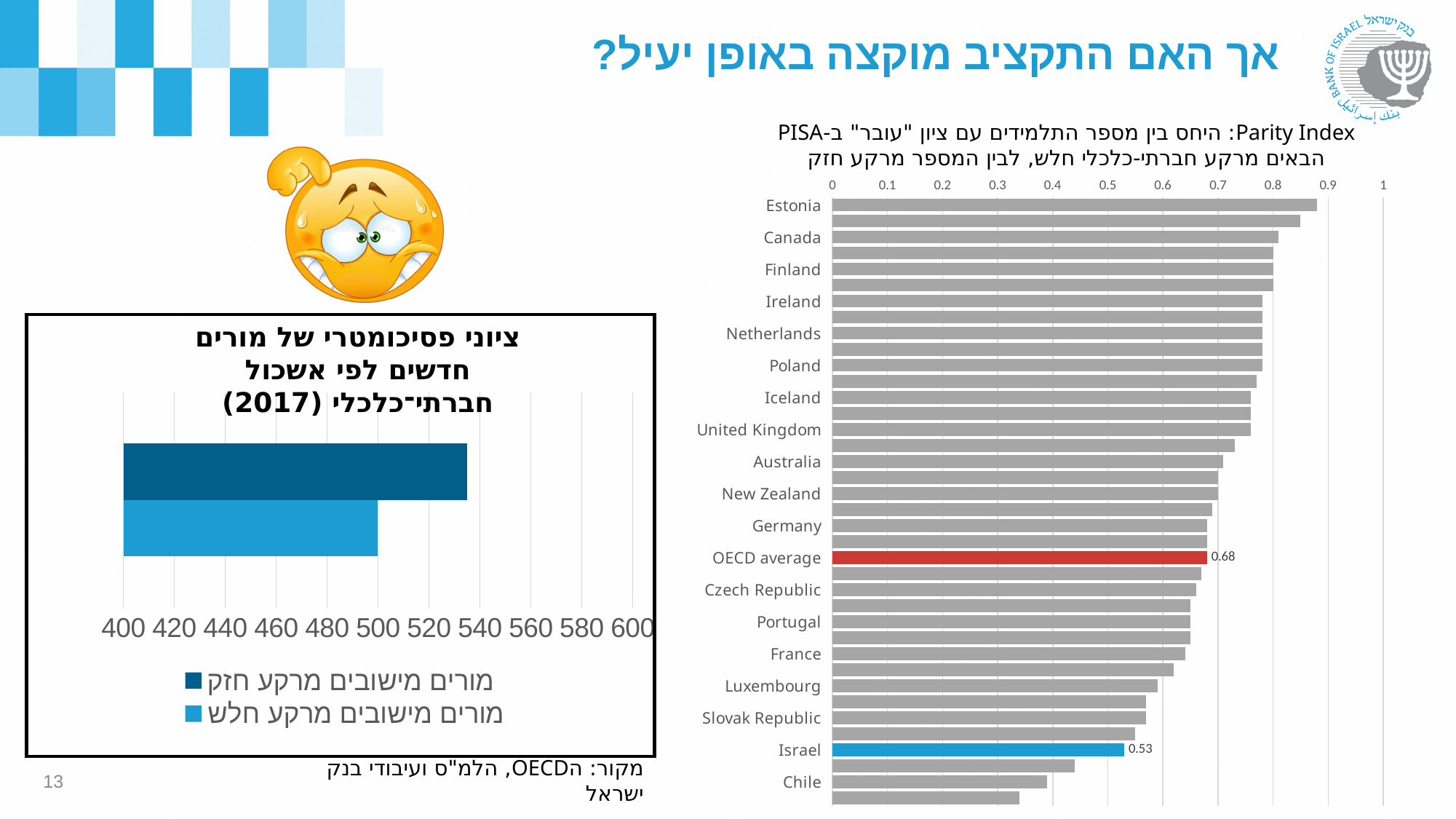
In the Parity Index chart on the right, is the value for Chile greater or less than 0.5? less What kind of chart is the Parity Index chart on the right? bar chart In the Parity Index chart on the right, is the value for Estonia greater or less than 0.8? greater In the Parity Index chart on the right, what is the value for Israel? 0.53 In the Parity Index chart on the right, what is the value for the OECD average? 0.68 In the Parity Index chart on the right, which labelled country has the highest value? Estonia In the left chart on psychometric scores of new teachers (2017), is the value for teachers from a strong socio-economic background greater or less than 520? greater In the Parity Index chart on the right, what colour is the bar for Israel? blue In the Parity Index chart on the right, what is the difference between the OECD average and Israel? 0.15 In the left chart on psychometric scores of new teachers (2017), how many series does the legend list? 2 In the Parity Index chart on the right, which is larger: the value for Israel or the OECD average? OECD average